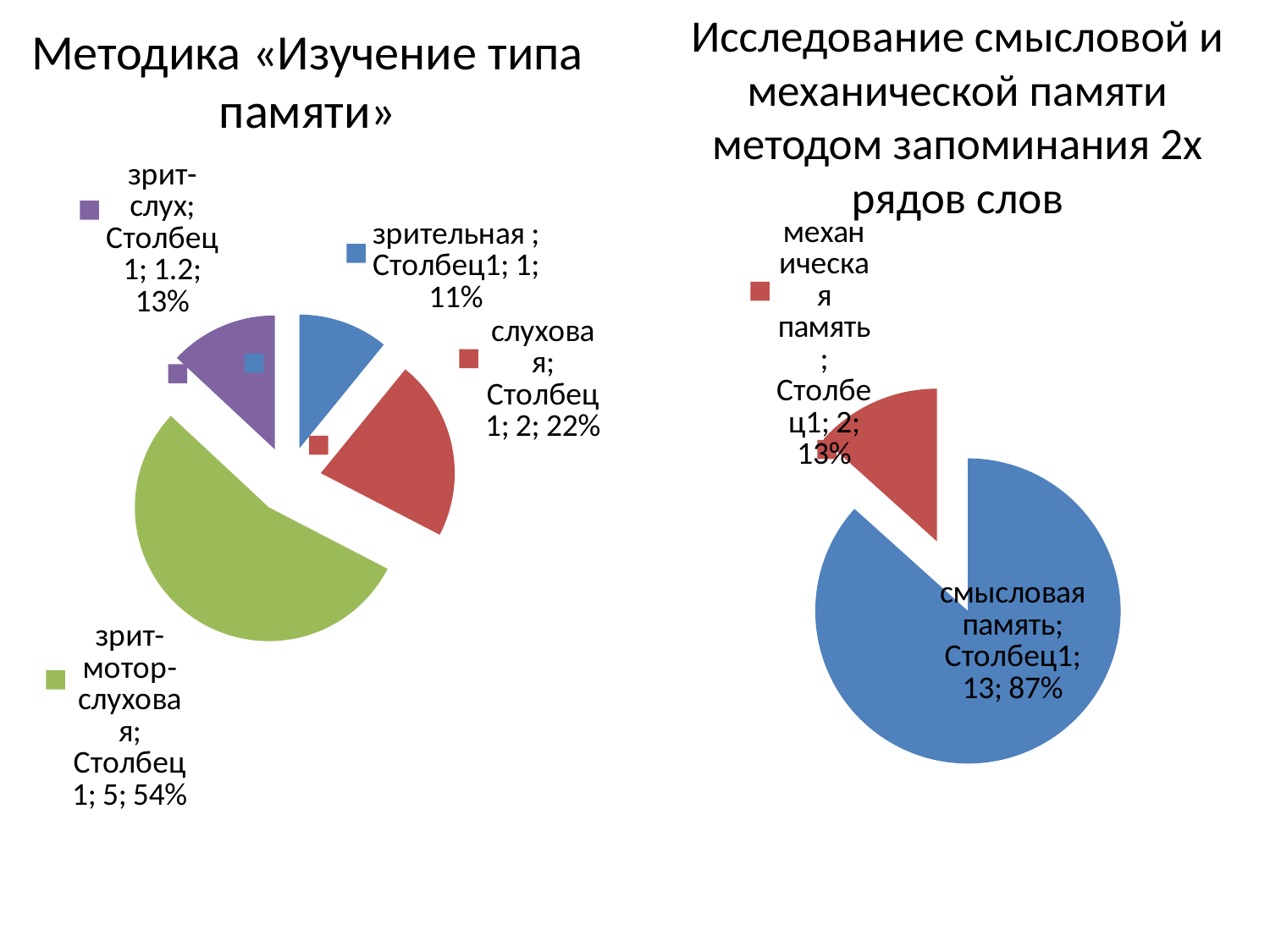
In the right pie chart (смысловой и механической памяти), what value is shown for механическая память? 2 What kind of chart is used on the left side of the slide, titled «Изучение типа памяти»? pie chart In the left pie chart («Изучение типа памяти»), which category has the smallest slice? зрительная In the left pie chart («Изучение типа памяти»), which category has the largest slice? зрит-мотор-слуховая How many slices does the left pie chart («Изучение типа памяти») have? 4 In the left pie chart («Изучение типа памяти»), what share does the слуховая slice have? 22% In the right pie chart (смысловой и механической памяти), what is the difference between the values for смысловая память and механическая память? 11 In the right pie chart (смысловой и механической памяти), what share does смысловая память have? 87% In the left pie chart («Изучение типа памяти»), what is the difference between the values for слуховая and зрительная? 1 In the right pie chart (смысловой и механической памяти), which is larger: смысловая память or механическая память? смысловая память In the left pie chart («Изучение типа памяти»), what value is shown for зрит-мотор-слуховая? 5 In the left pie chart («Изучение типа памяти»), what share does the зрит-слух slice have? 13%